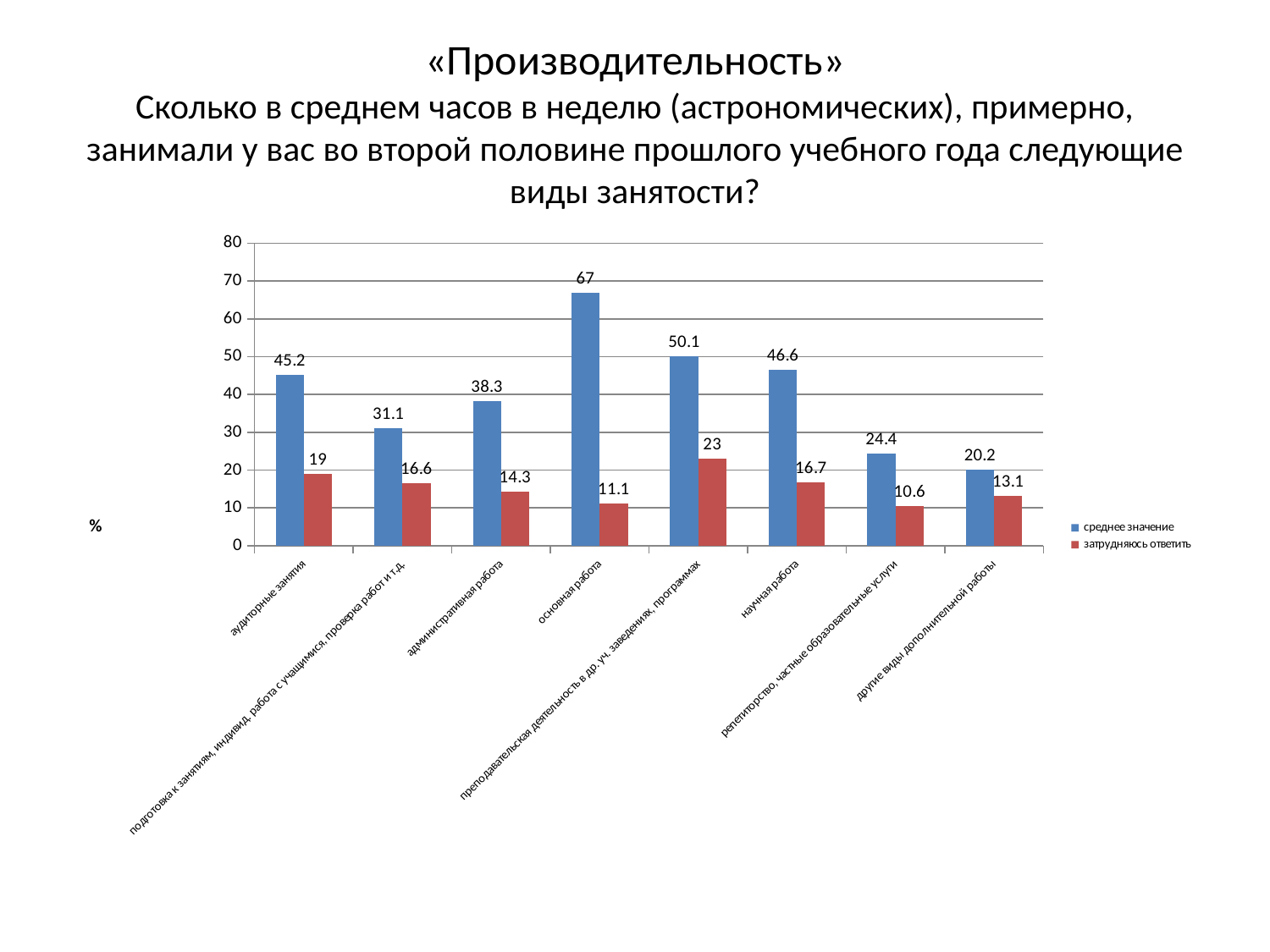
Is the "среднее значение" for "репетиторство, частные образовательные услуги" greater or less than 30? less How many series does the legend list? 2 Which category has the lowest "затрудняюсь ответить" value? репетиторство, частные образовательные услуги What kind of chart is shown on the slide? bar chart What is the difference between "среднее значение" and "затрудняюсь ответить" for "административная работа"? 24 What is the value of "затрудняюсь ответить" for "аудиторные занятия"? 19 Which category has the highest "среднее значение"? основная работа Which is larger: "среднее значение" for "аудиторные занятия" or for "научная работа"? научная работа Which colour represents the series "затрудняюсь ответить"? red What is the value of "среднее значение" for "научная работа"? 46.6 What is the value of "среднее значение" for "основная работа"? 67 How many categories are shown on the x axis? 8